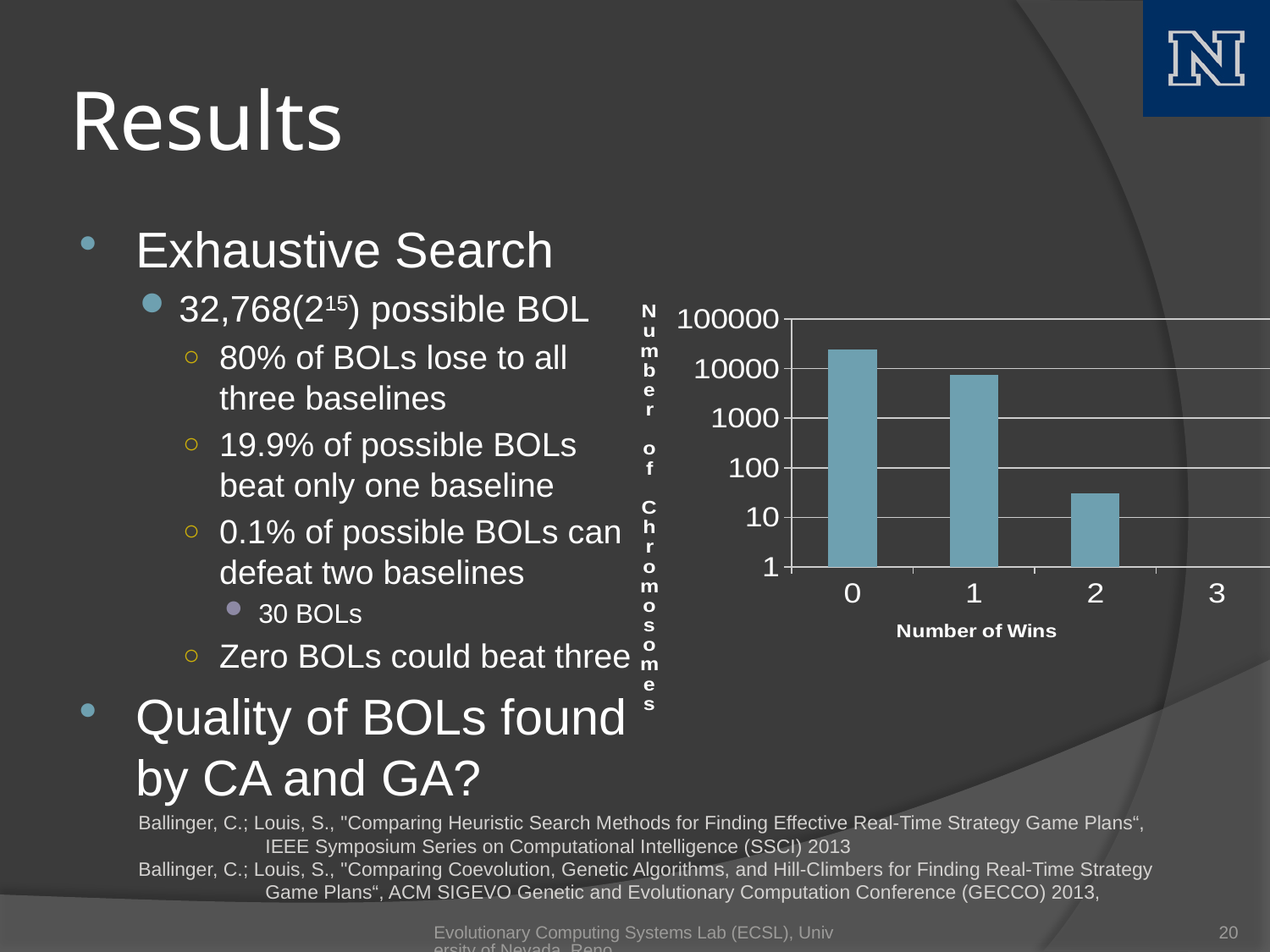
What is the title of the x axis of the chart? Number of Wins Is the value for 0 wins greater or less than 10000? greater Which number of wins has the highest number of chromosomes? 0 Which is larger, the value for 0 wins or the value for 1 win? 0 wins Is the value for 1 win greater or less than 1000? greater Is the value for 2 wins greater or less than 10? greater What kind of chart is shown on the slide? bar chart How many categories are shown on the x axis of the chart? 4 What is the highest tick value shown on the y axis of the chart? 100000 Do the bar values rise or fall as the number of wins increases? fall